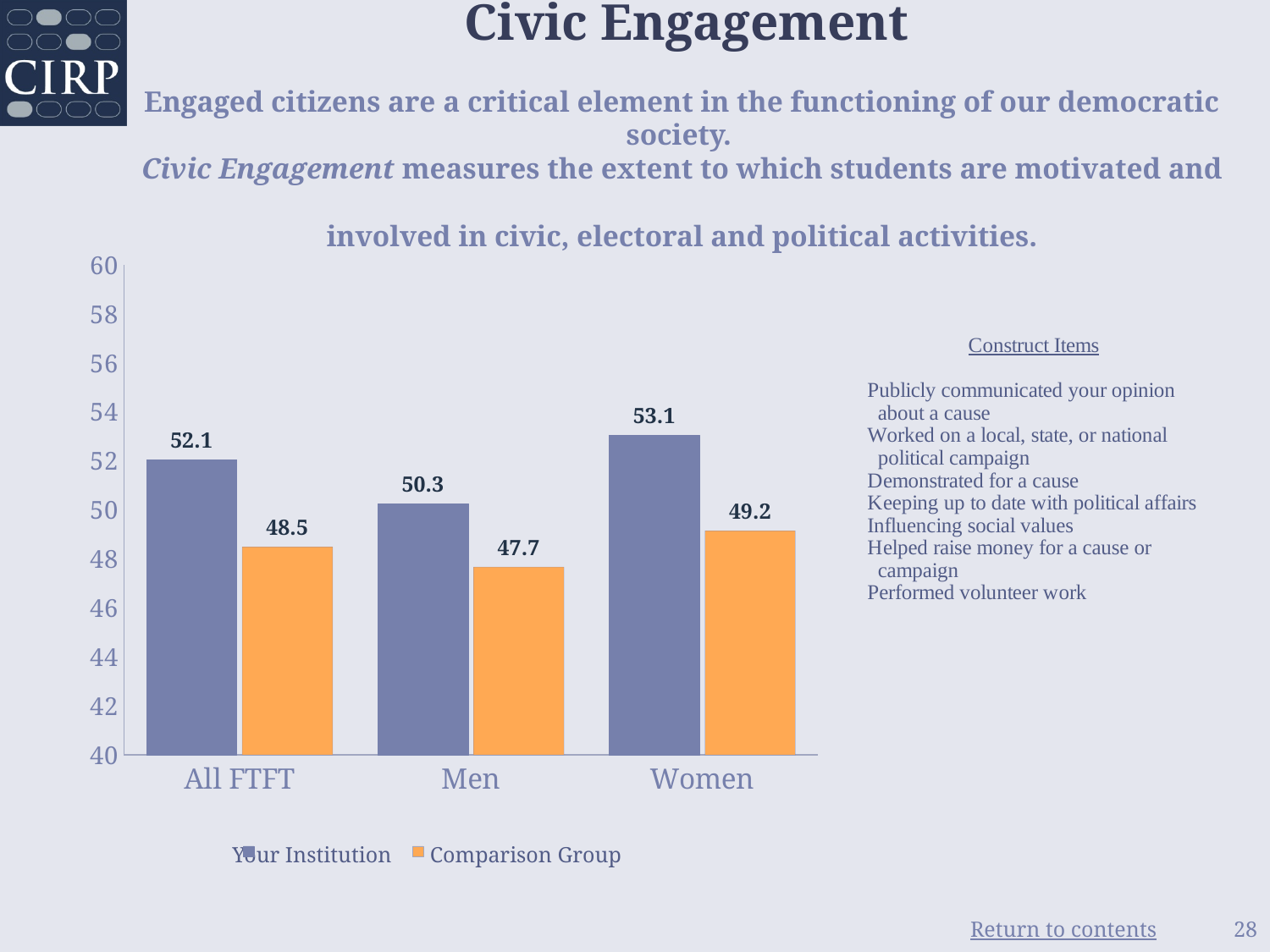
How many categories are shown on the x axis? 3 What is the Your Institution value for Women? 53.1 Which category has the lowest Comparison Group value? Men What is the Comparison Group value for Men? 47.7 What kind of chart is shown on the slide? bar chart Which category has the highest Your Institution value? Women What is the Your Institution value for All FTFT? 52.1 What is the difference between the Your Institution and Comparison Group values for Women? 3.9 Which is larger for Men: the Your Institution value or the Comparison Group value? Your Institution How many series does the legend list? 2 Is the Comparison Group value for Women greater or less than 50? less What is the difference between the Your Institution and Comparison Group values for All FTFT? 3.6